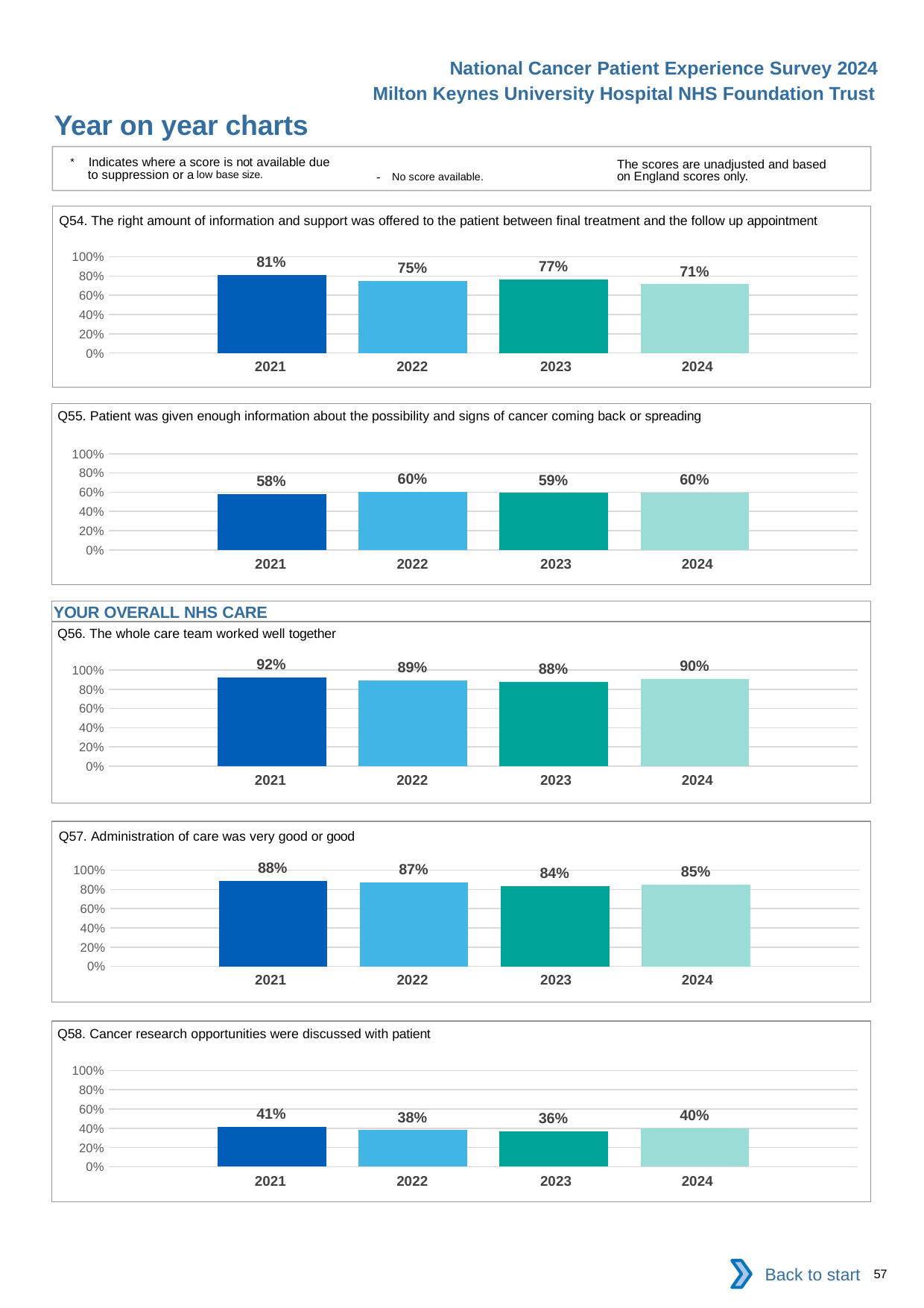
In the Q54 chart, which year has the lowest value? 2024 In the Q55 chart, what is the value for 2023? 59% In the Q58 chart, is the value for 2021 greater or less than 60%? less What kind of chart is the Q54 chart? bar chart In the Q58 chart, which year has the lowest value? 2023 In the Q55 chart, what is the difference between the 2022 and 2021 values? 2% In the Q56 chart, which year has the highest value? 2021 How many years are shown in the Q58 chart? 4 In the Q57 chart, what is the value for 2023? 84% In the Q54 chart, what is the value for 2021? 81% In the Q57 chart, what is the difference between the 2021 and 2024 values? 3% In the Q56 chart, is the value for 2024 larger or smaller than the value for 2023? larger